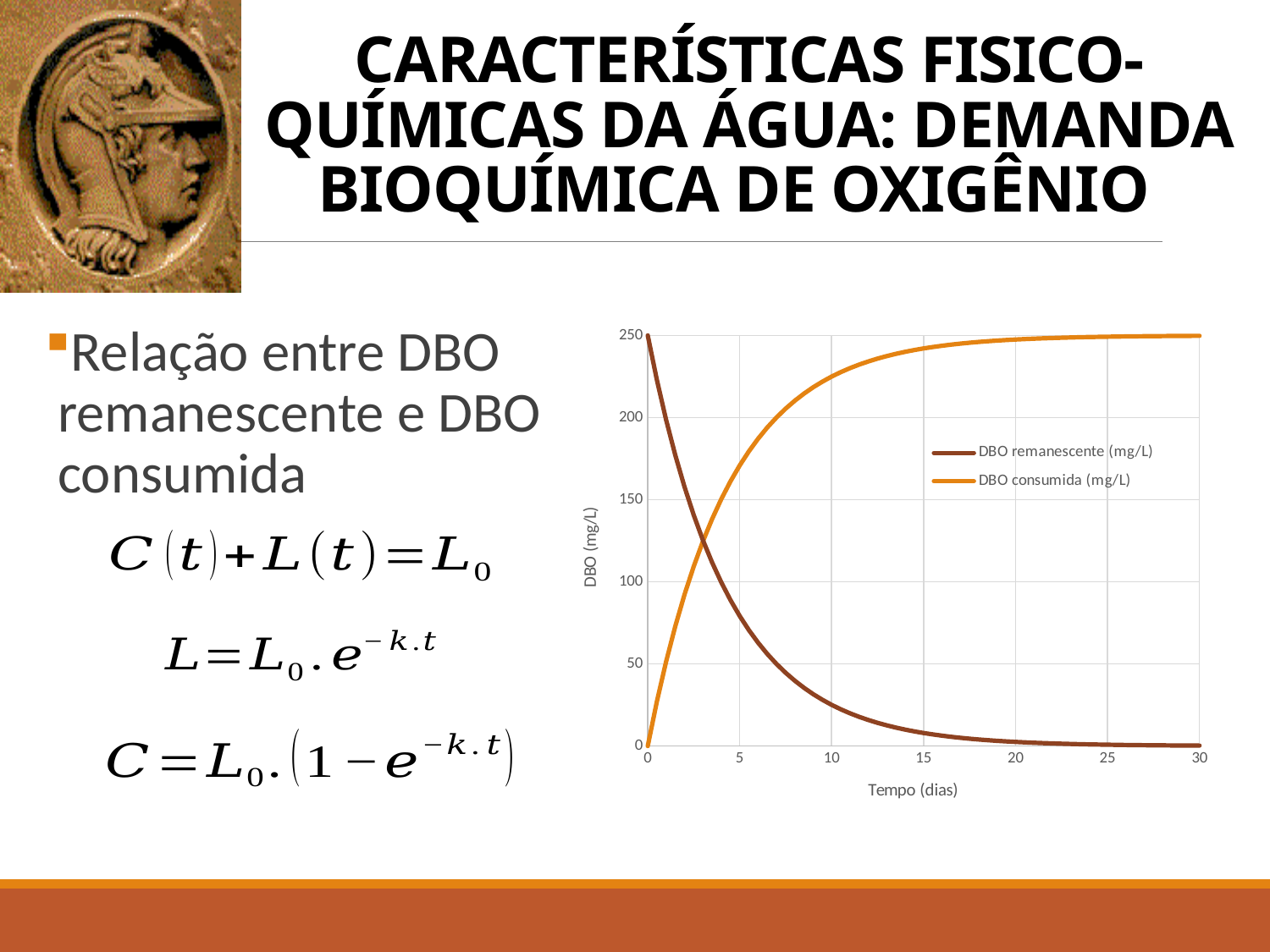
Is the value of DBO remanescente (mg/L) at 10 days greater or less than 50? less Does the DBO remanescente (mg/L) series rise or fall as Tempo (dias) increases? fall Is the value of DBO consumida (mg/L) at 10 days greater or less than 200? greater What kind of chart is shown on the slide? line chart What is the value of DBO remanescente (mg/L) at 0 days? 250 Is the value of DBO remanescente (mg/L) at 20 days greater or less than 50? less What is the value of DBO consumida (mg/L) at 0 days? 0 How many series does the chart legend list? 2 What is the title of the x axis of the chart? Tempo (dias) At 20 days, which series has the higher value, DBO remanescente (mg/L) or DBO consumida (mg/L)? DBO consumida (mg/L) Does the DBO consumida (mg/L) series rise or fall as Tempo (dias) increases? rise